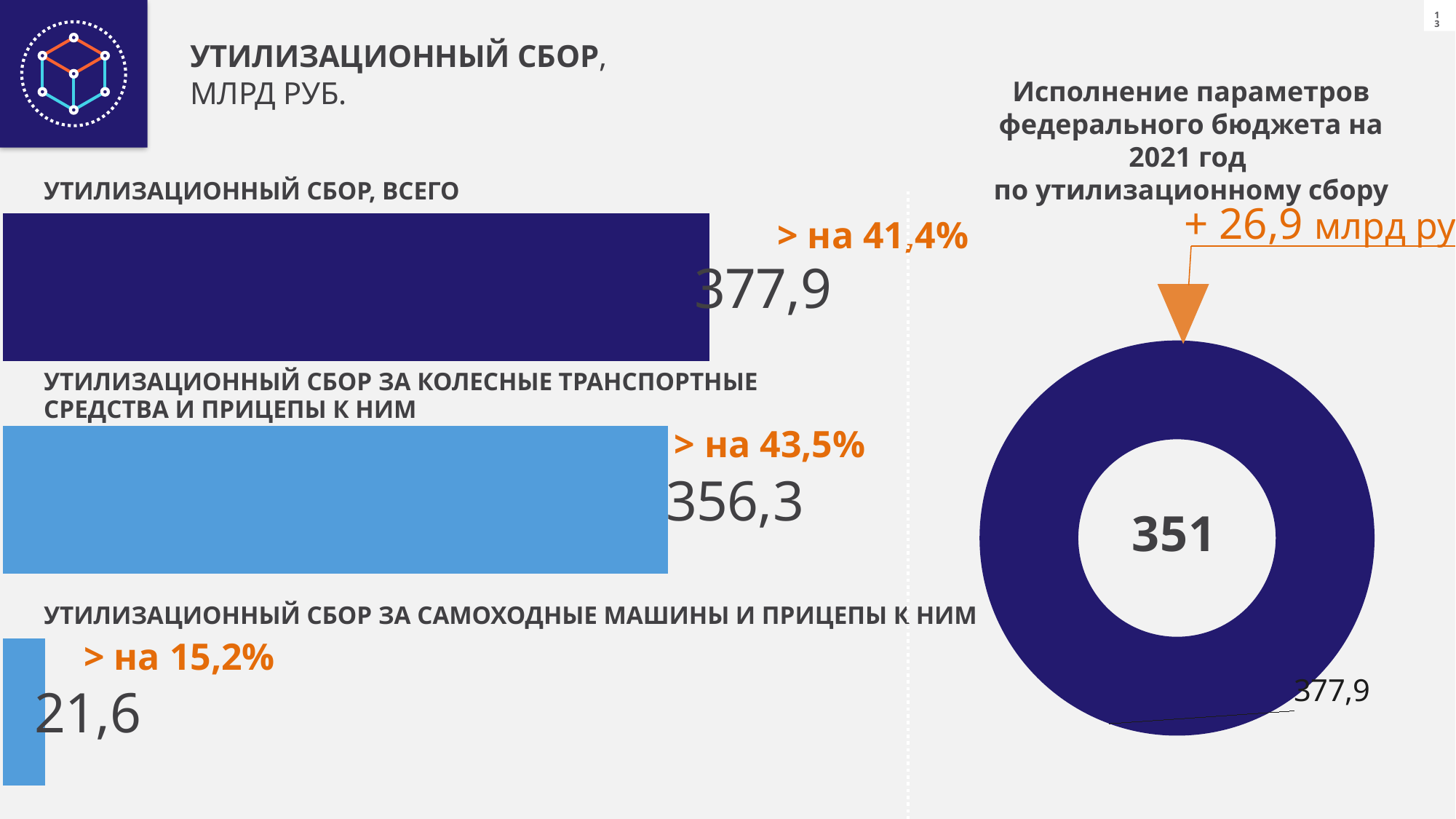
On the bar chart on the left, what is the value for 'Утилизационный сбор за колесные транспортные средства и прицепы к ним'? 356,3 On the bar chart on the left, what is the value for 'Утилизационный сбор, всего'? 377,9 On the bar chart on the left, what is the difference between the value for wheeled vehicles (356,3) and the value for self-propelled machines (21,6)? 334,7 How many bars are shown on the bar chart on the left? 3 On the bar chart on the left, which category has the highest value? Утилизационный сбор, всего What type of chart is shown on the left side of the slide? Bar chart On the bar chart on the left, what growth percentage is shown next to the bar for self-propelled machines and trailers? > на 15,2% What type of chart is shown on the right side of the slide? Donut chart On the donut chart on the right ('Исполнение параметров федерального бюджета на 2021 год по утилизационному сбору'), what value is shown in the centre? 351 On the bar chart on the left, which is larger: the value for wheeled vehicles and trailers or the value for self-propelled machines and trailers? Wheeled vehicles and trailers (356,3) On the bar chart on the left, which category has the lowest value? Утилизационный сбор за самоходные машины и прицепы к ним On the bar chart on the left, what is the value for 'Утилизационный сбор за самоходные машины и прицепы к ним'? 21,6